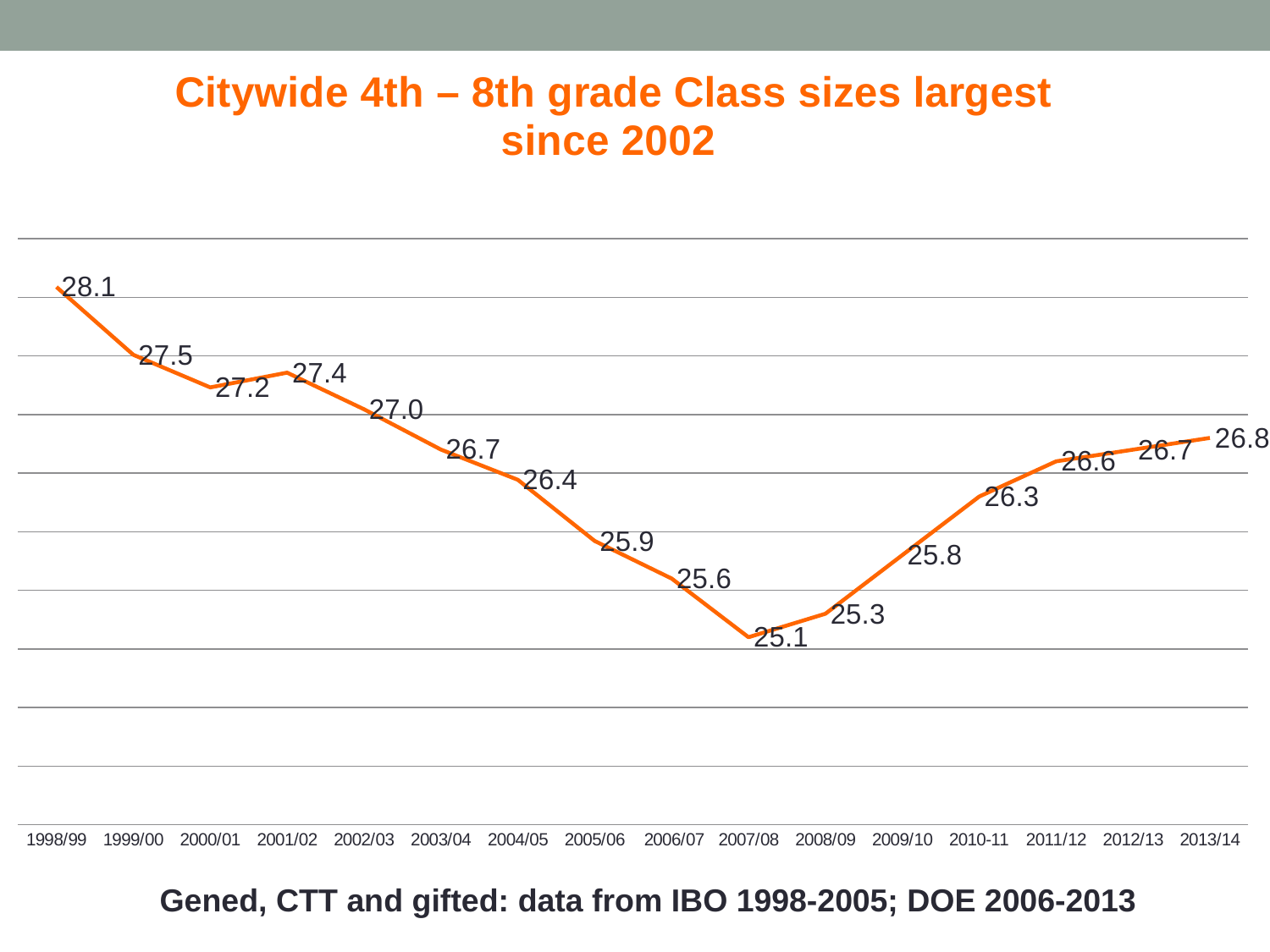
What kind of chart is shown on the slide? Line chart How many school years are plotted on the chart? 16 Do the class size values rise or fall from 2007/08 to 2013/14? Rise What is the class size value for 1998/99? 28.1 What is the difference between the class size in 1998/99 and in 2007/08? 3.0 What is the class size value for 2007/08? 25.1 What is the class size value for 2013/14? 26.8 Which is larger, the class size in 2001/02 or in 2011/12? 2001/02 What is the class size value for 2003/04? 26.7 What is the difference between the class size in 2013/14 and in 2007/08? 1.7 Which school year has the lowest class size value? 2007/08 Which school year has the highest class size value? 1998/99